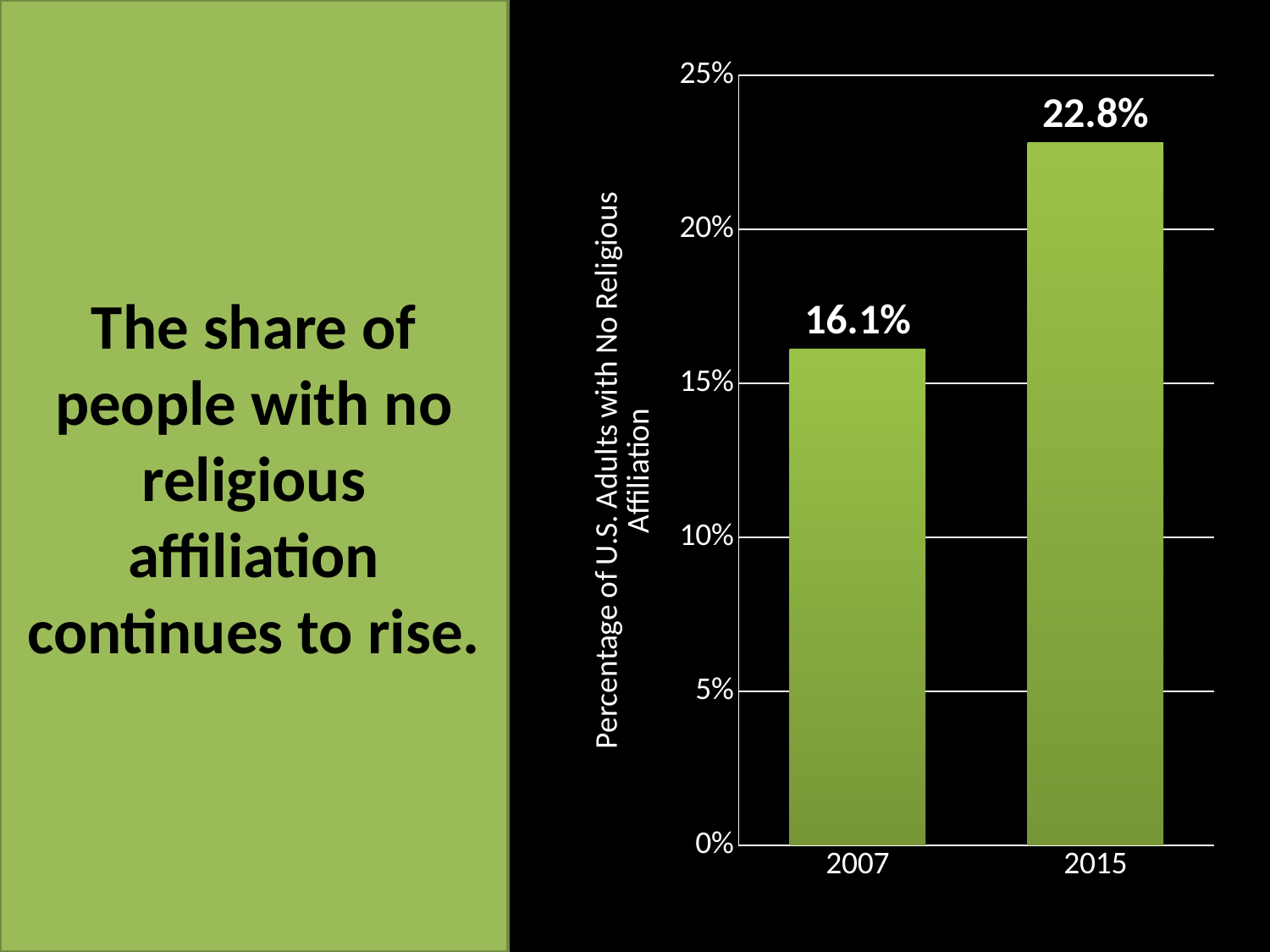
Which year has the higher percentage of U.S. adults with no religious affiliation? 2015 Is the value for 2007 greater or less than 20%? less By how many percentage points did the share of U.S. adults with no religious affiliation change from 2007 to 2015? 6.7 percentage points Which year has the lower percentage of U.S. adults with no religious affiliation? 2007 What kind of chart is shown on the slide? bar chart Is the value for 2015 larger or smaller than the value for 2007? larger Is the value for 2015 greater or less than 20%? greater How many years are shown on the x axis of the chart? 2 What is the percentage of U.S. adults with no religious affiliation in 2015? 22.8% What is the percentage of U.S. adults with no religious affiliation in 2007? 16.1% Do the values rise or fall from 2007 to 2015? rise What is the label on the vertical axis of the chart? Percentage of U.S. Adults with No Religious Affiliation